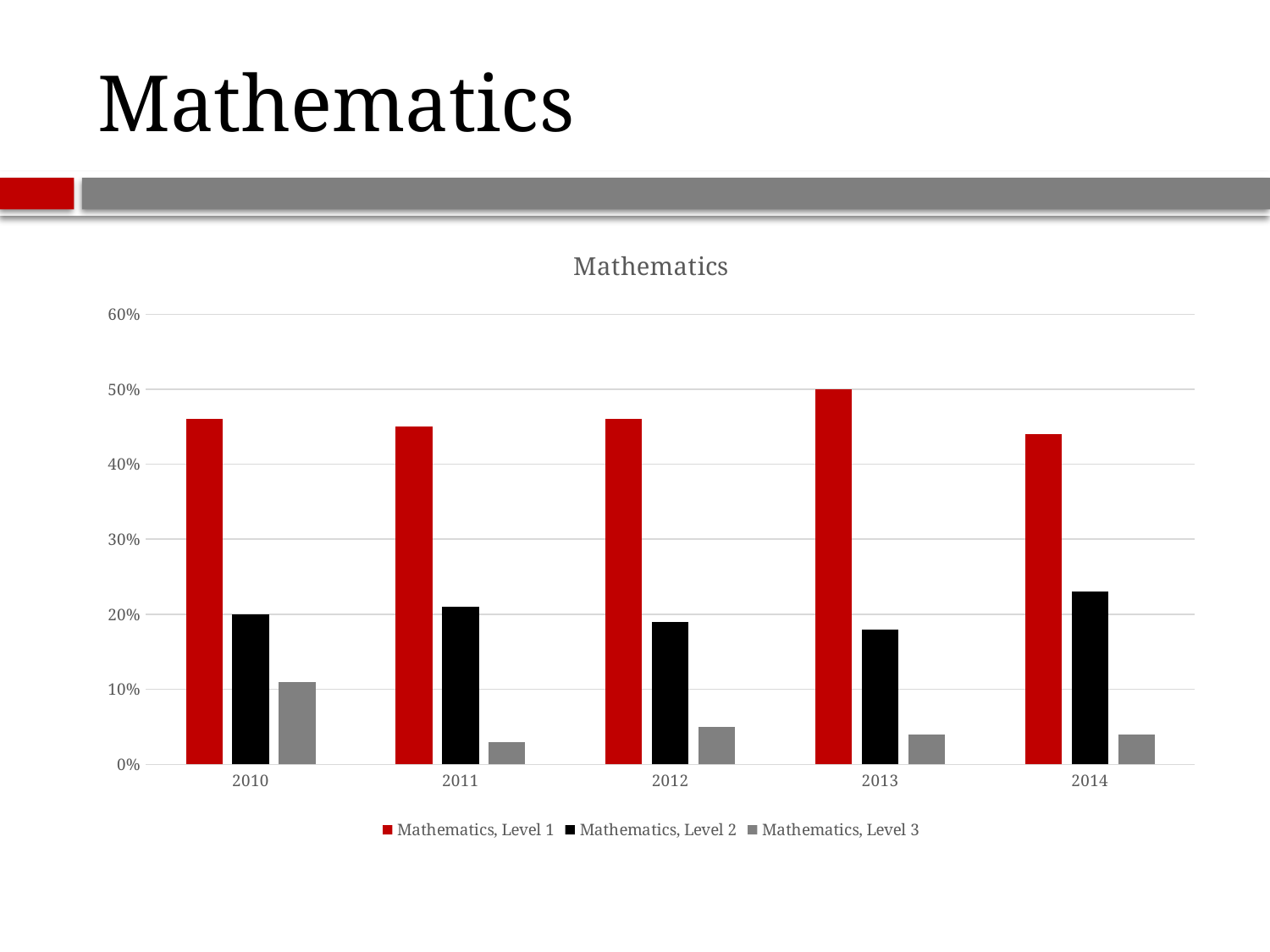
What type of chart is shown on the slide? Bar chart Is the value for Mathematics, Level 3 in 2010 greater or less than 10%? greater What is the title of the chart? Mathematics In which year is Mathematics, Level 3 highest? 2010 How many series does the legend list? 3 What is the value for Mathematics, Level 2 in 2010? 20% What is the value for Mathematics, Level 1 in 2013? 50% In which year is Mathematics, Level 1 highest? 2013 Is the value for Mathematics, Level 2 in 2014 greater or less than 20%? greater Which is larger in 2012: Mathematics, Level 1 or Mathematics, Level 2? Mathematics, Level 1 How many years are shown on the x axis? 5 Is the value for Mathematics, Level 3 in 2011 greater or less than 5%? less